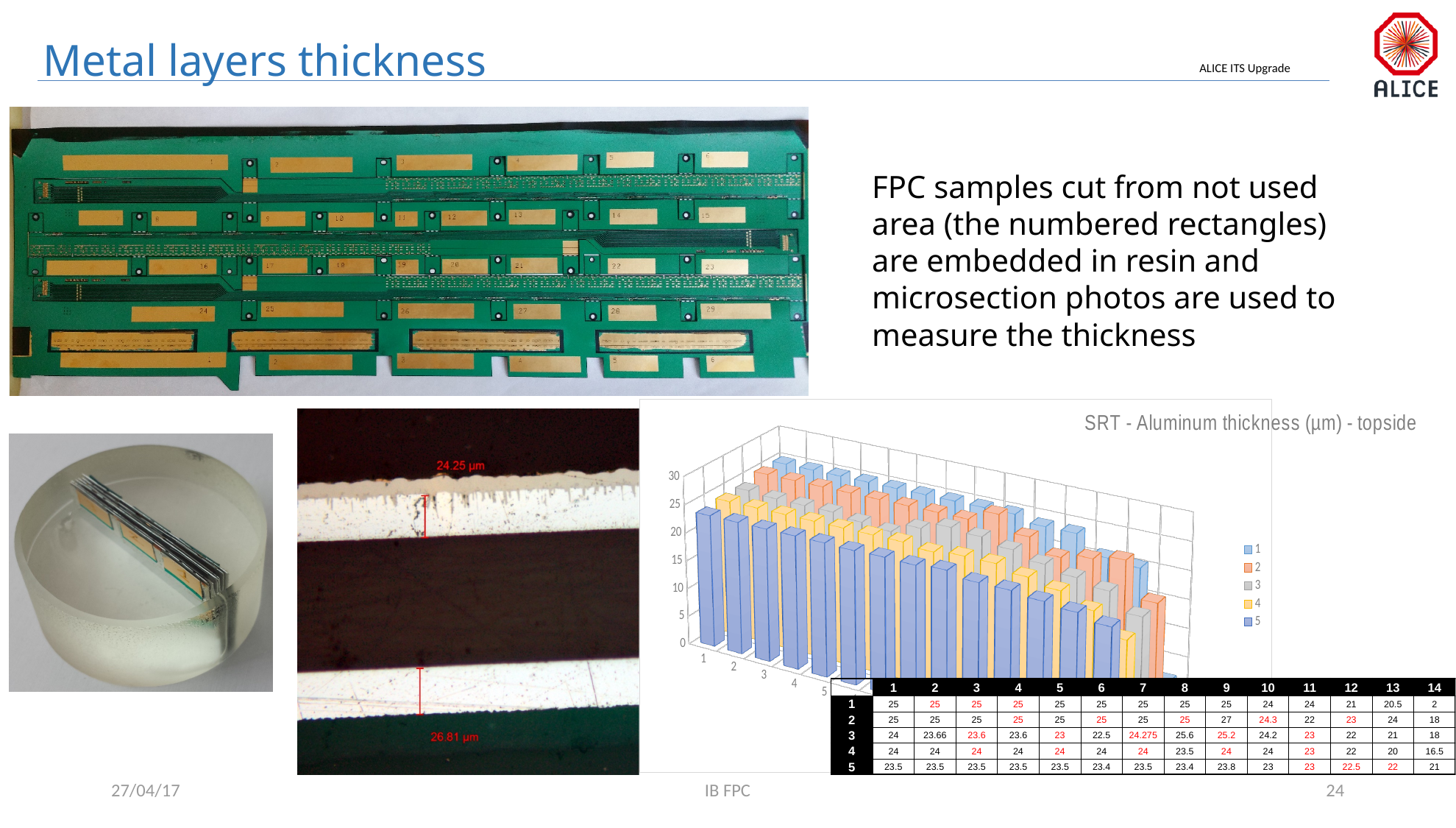
In the aluminum thickness chart, which category has the lowest value for series 1? 14 How many categories are plotted along the x axis of the aluminum thickness chart? 14 In the aluminum thickness chart, what is the difference between the series 1 values at category 13 and category 14? 18.5 In the aluminum thickness chart, at category 14, which is larger: series 4 or series 5? series 5 In the aluminum thickness chart, what is the value for series 3 at category 7? 24.275 What kind of chart is shown under the title 'SRT - Aluminum thickness (µm) - topside'? bar chart How many series does the legend of the aluminum thickness chart list? 5 In the aluminum thickness chart, which category has the highest value for series 2? 9 In the aluminum thickness chart, what is the value for series 2 at category 9? 27 In the aluminum thickness chart, what is the value for series 1 at category 14? 2 What is the title of the 3D bar chart on the slide? SRT - Aluminum thickness (µm) - topside In the aluminum thickness chart, do the values for series 4 rise or fall from category 10 to category 14? fall